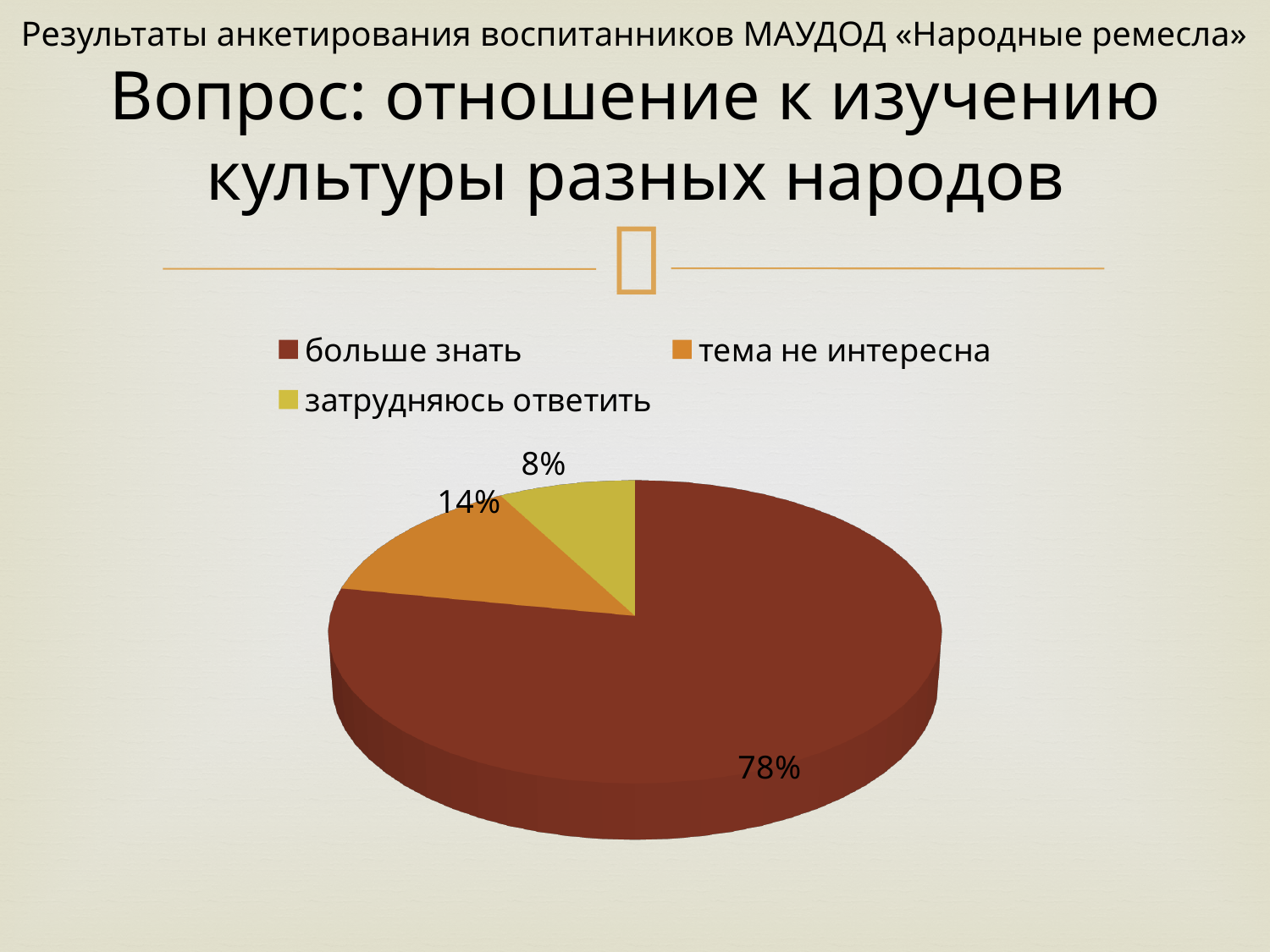
Which category has the smallest slice of the pie? затрудняюсь ответить How many entries does the legend list? 3 Which is larger: the share for "тема не интересна" or for "затрудняюсь ответить"? тема не интересна What kind of chart is shown on the slide? pie chart Which category has the largest slice of the pie? больше знать What share of the pie does "больше знать" have? 78% What is the difference between the shares of "больше знать" and "тема не интересна"? 64% What share of the pie does "затрудняюсь ответить" have? 8% What is the difference between the shares of "тема не интересна" and "затрудняюсь ответить"? 6% How many categories does the pie chart show? 3 What colour is the slice for "затрудняюсь ответить"? yellow What share of the pie does "тема не интересна" have? 14%